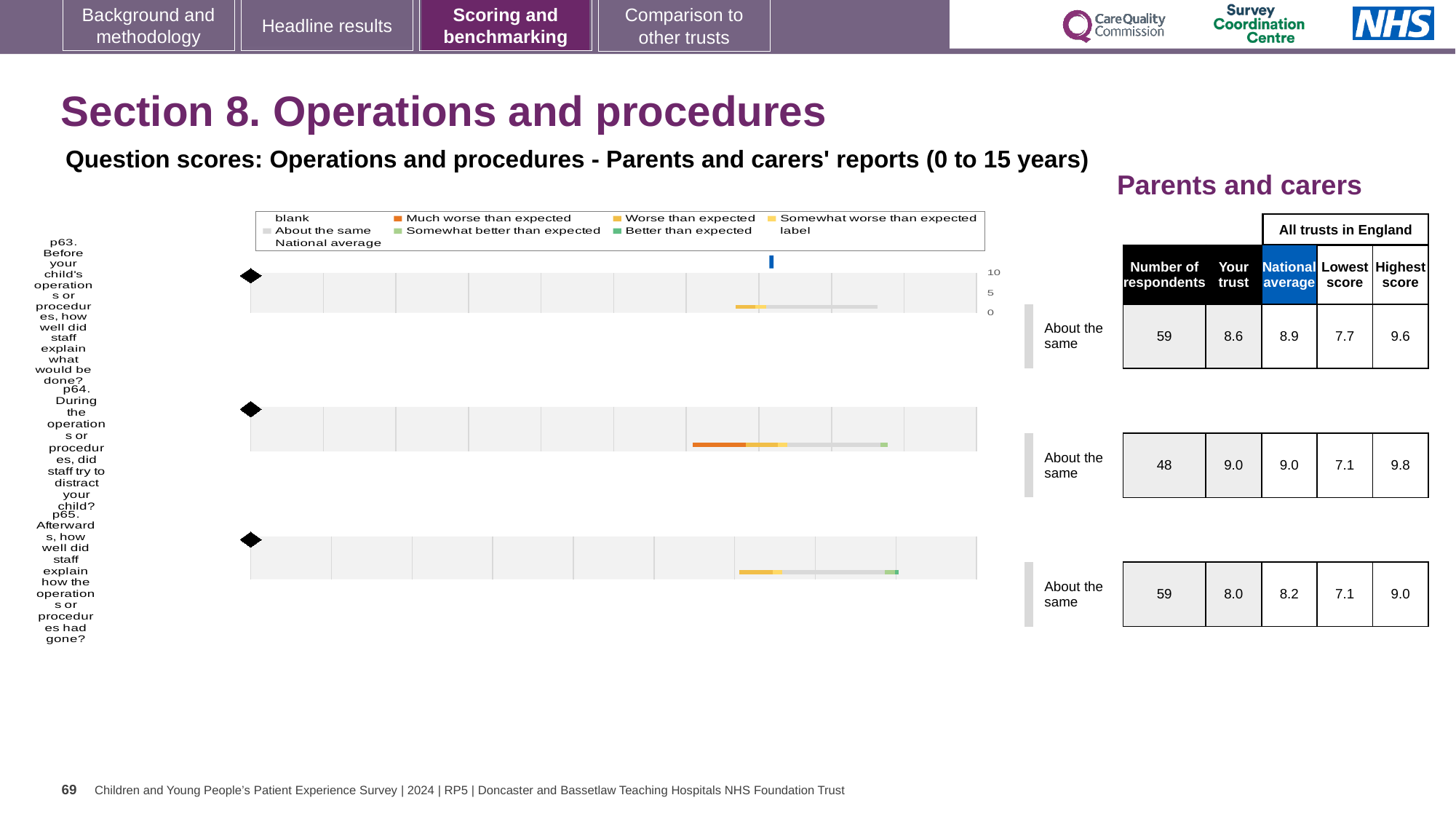
What is the national average score for p63? 8.9 What kind of chart is used to show the question scores for p63, p64 and p65? Bar chart What is the lowest score across all trusts in England for p64? 7.1 What benchmark category is shown for all three questions (p63, p64, p65)? About the same What is the 'Your trust' score for p63 (Before your child's operations or procedures, how well did staff explain what would be done?)? 8.6 Which question has the highest 'Your trust' score? p64 What is the highest score across all trusts in England for p65 (Afterwards, how well did staff explain how the operations or procedures had gone?)? 9.0 How many questions (p63, p64, p65) are plotted on the slide? 3 For p63, which is larger: the 'Your trust' score or the national average? National average How many respondents answered p64 (During the operations or procedures, did staff try to distract your child?)? 48 Which question has the lowest 'Your trust' score? p65 What is the difference between the national average and the 'Your trust' score for p63? 0.3